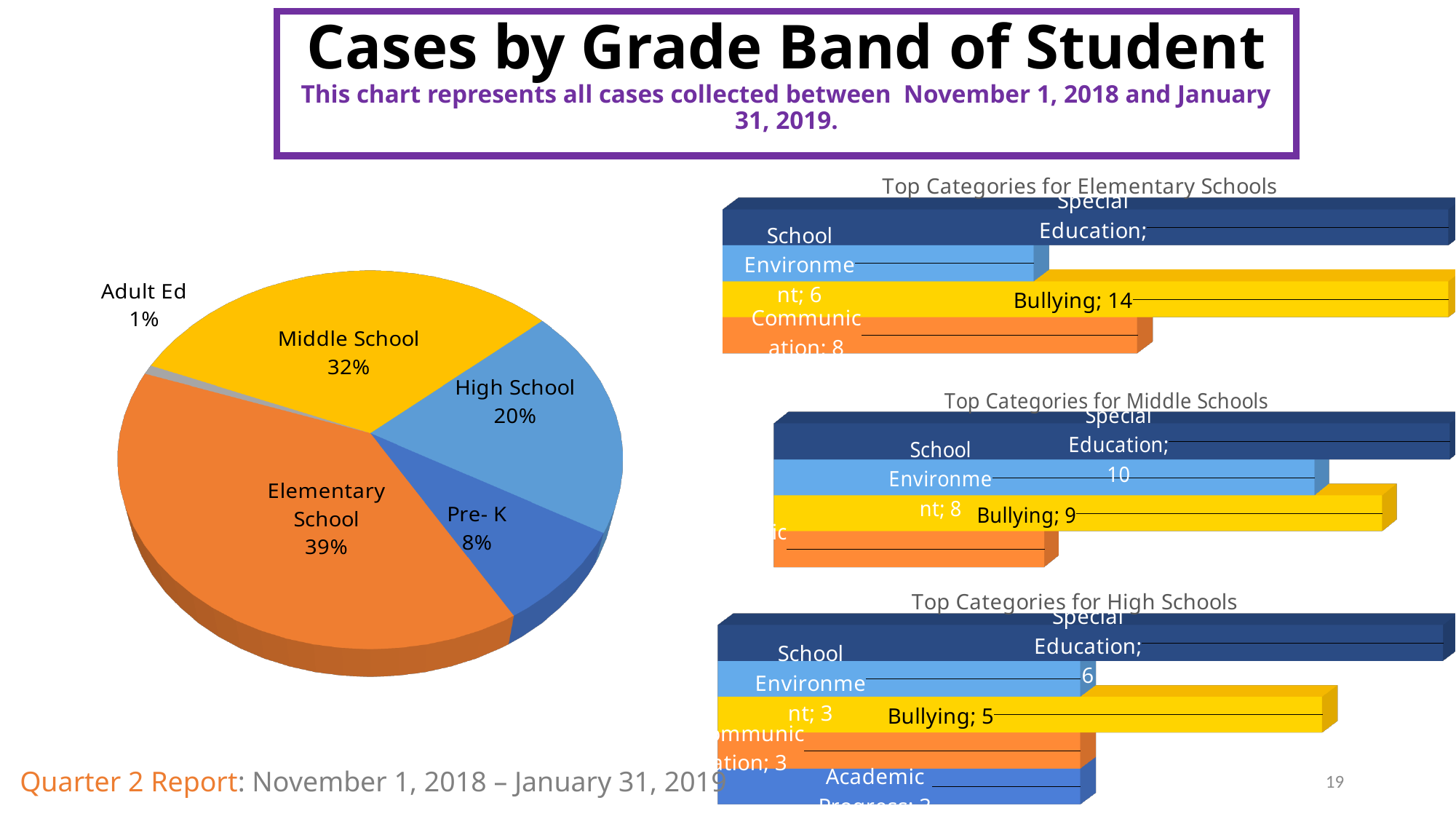
In the pie chart, which has a larger share: Middle School or High School? Middle School In the 'Top Categories for High Schools' chart, what is the value for Bullying? 5 In the 'Top Categories for Elementary Schools' chart, what is the value for Bullying? 14 In the pie chart, what percentage of cases are from Elementary School? 39% In the 'Top Categories for Elementary Schools' chart, what is the difference between Bullying and School Environment? 8 How many slices does the pie chart have? 5 In the 'Top Categories for Middle Schools' chart, which category has the highest value? Special Education In the pie chart, what is the difference between the Middle School share and the High School share? 12% In the pie chart, which grade band has the largest share of cases? Elementary School In the 'Top Categories for Middle Schools' chart, what is the value for Special Education? 10 What type of chart is the chart on the left of the slide? Pie chart In the pie chart, which grade band has the smallest share of cases? Adult Ed